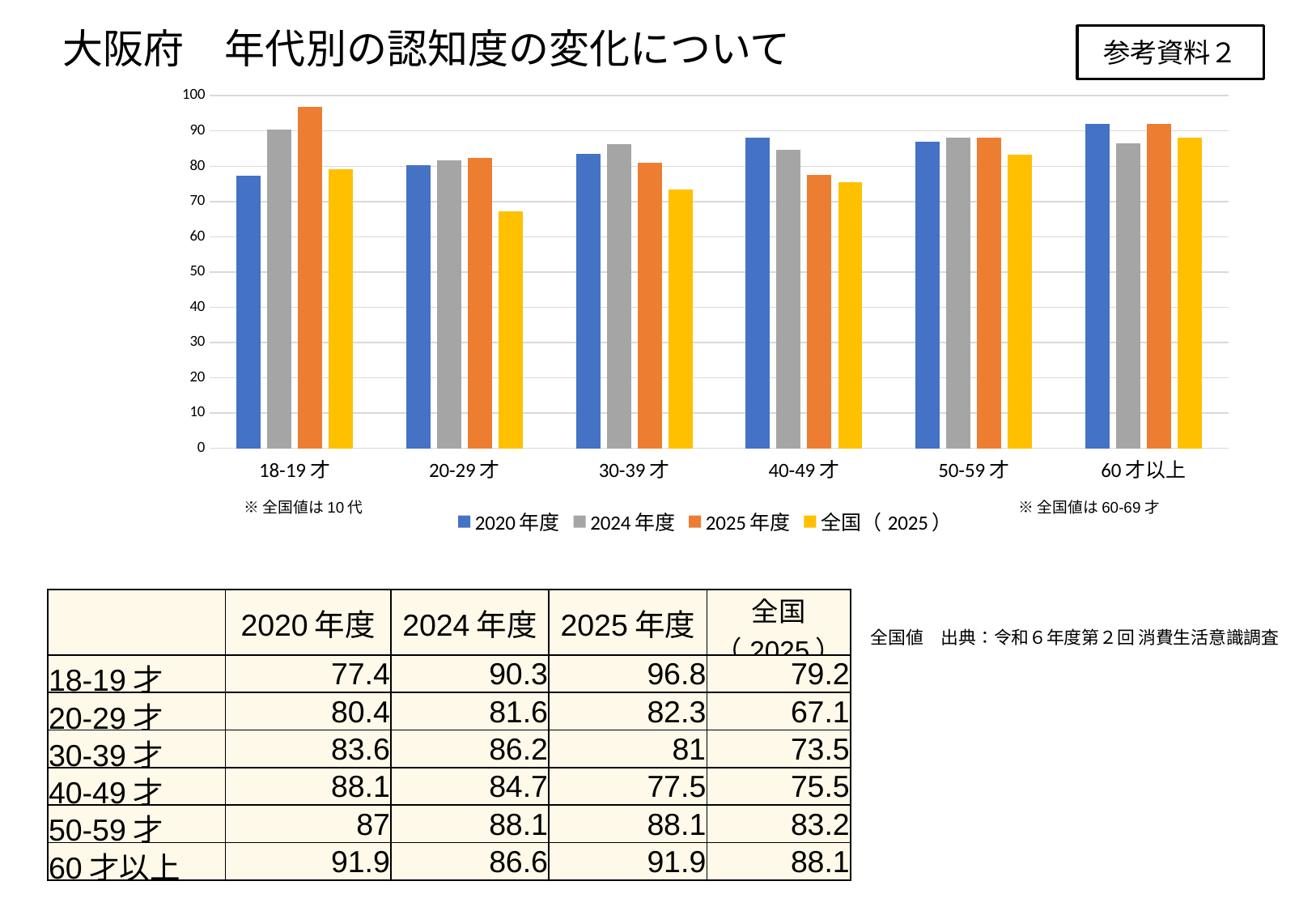
Is the 全国（2025） value for 30-39才 greater or less than 80? less How many series does the chart legend list? 4 Do the 2025年度 values rise or fall from 18-19才 to 40-49才? fall For 40-49才, which is larger: the 2020年度 value or the 2025年度 value? 2020年度 What is the 2025年度 value for 18-19才? 96.8 How many age-group categories are shown on the x axis of the chart? 6 Which colour represents the 2024年度 series in the chart? gray What kind of chart is shown on the slide? bar chart Which age group has the highest 2025年度 value? 18-19才 Which age group has the lowest 全国（2025） value? 20-29才 What is the difference between the 2025年度 and 2020年度 values for 18-19才? 19.4 What is the 全国（2025） value for 20-29才? 67.1